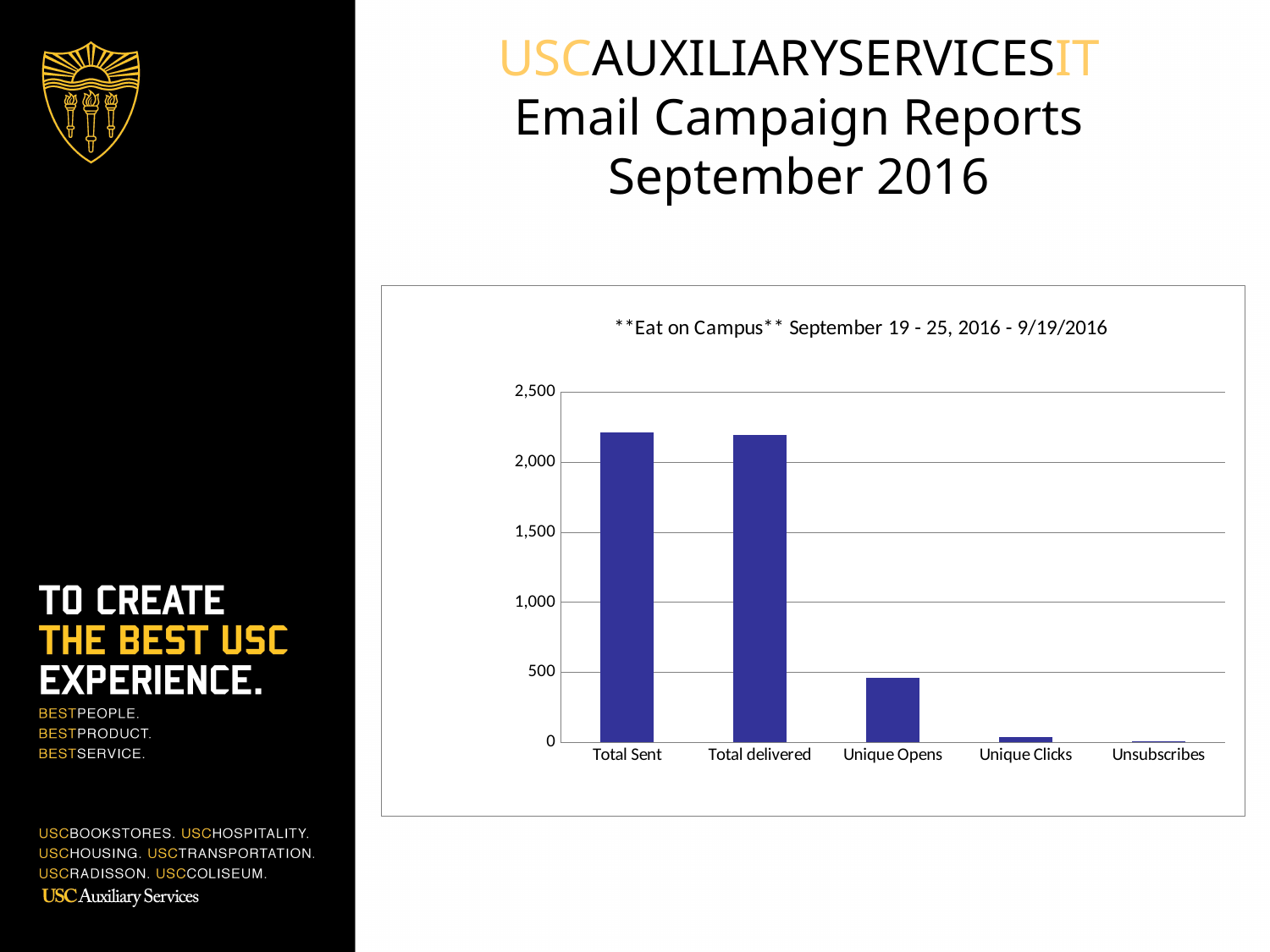
Is the value for Total Sent greater or less than 2,500? less Is the value for Total delivered greater or less than 2,000? greater What is the title of the chart? **Eat on Campus** September 19 - 25, 2016 - 9/19/2016 Is the value for Unique Clicks greater or less than 500? less What kind of chart is shown on the slide? bar chart Which category has the lowest value on the chart? Unsubscribes Which is larger, the value for Total delivered or the value for Unique Opens? Total delivered Do the values generally rise or fall moving from left to right across the categories? fall How many categories are plotted on the chart? 5 Which is larger, the value for Unique Clicks or the value for Unsubscribes? Unique Clicks